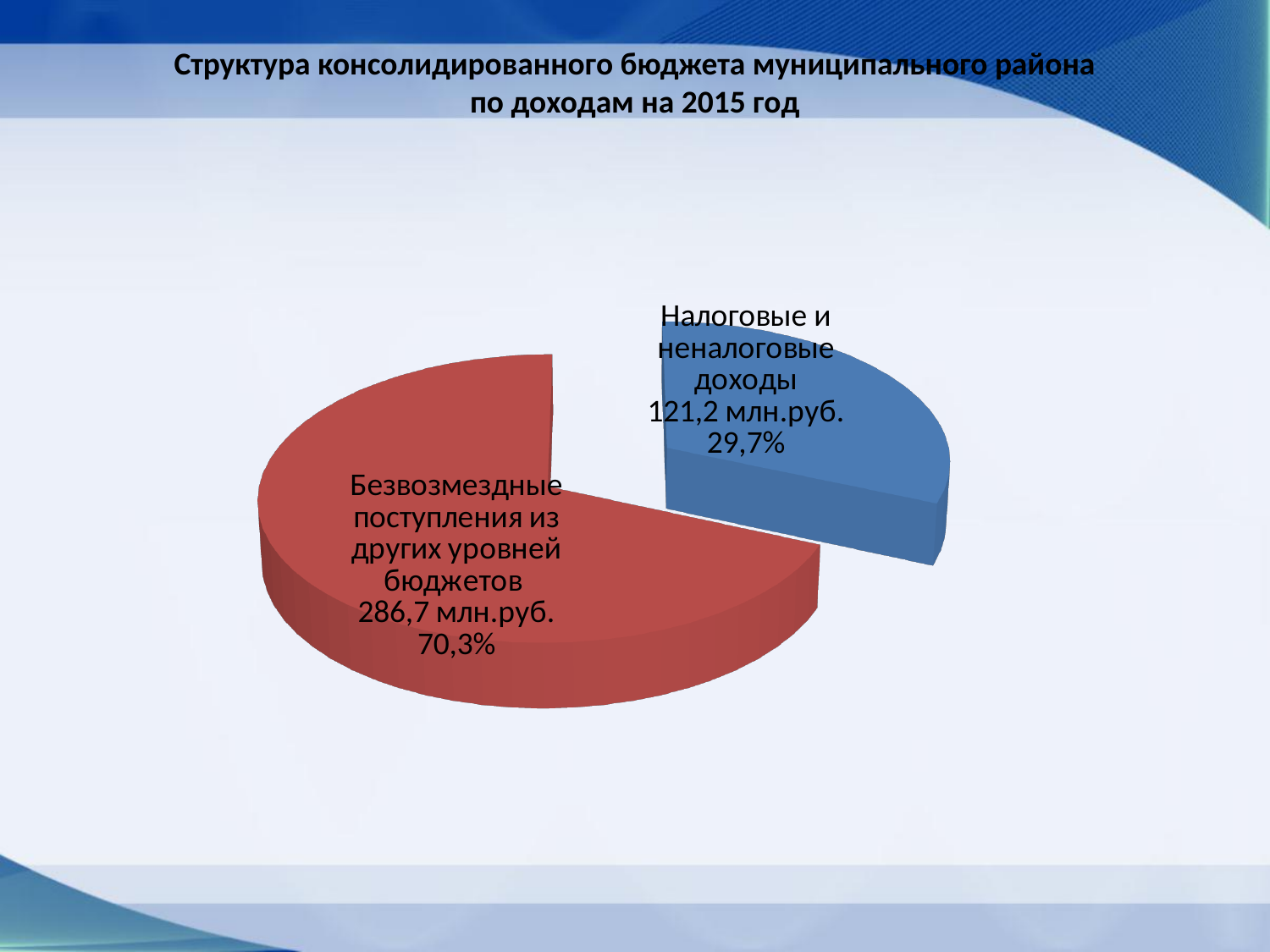
What is the title of the slide? Структура консолидированного бюджета муниципального района по доходам на 2015 год Which is larger: Налоговые и неналоговые доходы or Безвозмездные поступления из других уровней бюджетов? Безвозмездные поступления из других уровней бюджетов What colour is the slice for Налоговые и неналоговые доходы? Blue Which category has the largest slice? Безвозмездные поступления из других уровней бюджетов How many slices does the pie chart have? 2 What is the value for Налоговые и неналоговые доходы? 121,2 млн.руб. What is the difference in млн.руб. between Безвозмездные поступления из других уровней бюджетов and Налоговые и неналоговые доходы? 165,5 млн.руб. What kind of chart is shown on the slide? Pie chart Which category has the smallest slice? Налоговые и неналоговые доходы What share of the pie does Налоговые и неналоговые доходы represent? 29,7% What share of the pie does Безвозмездные поступления из других уровней бюджетов represent? 70,3% What is the value for Безвозмездные поступления из других уровней бюджетов? 286,7 млн.руб.